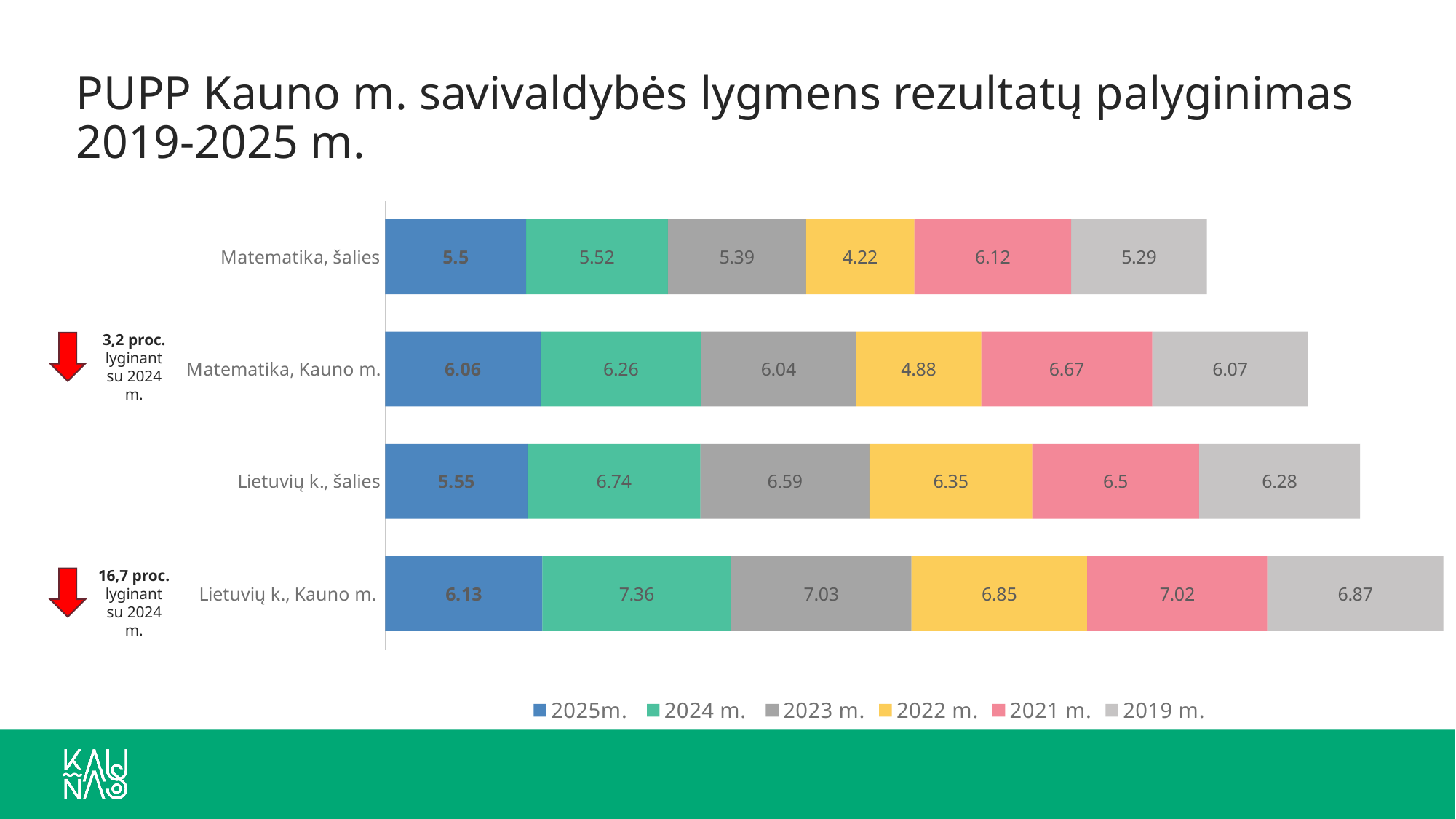
For Matematika, šalies, which is larger: the 2024 m. value or the 2023 m. value? 2024 m. Which category has the highest value in the 2024 m. series? Lietuvių k., Kauno m. What is the value for Lietuvių k., šalies in the 2024 m. series? 6.74 How many series does the legend list? 6 How many categories are shown on the chart? 4 What is the value for Matematika, šalies in the 2022 m. series? 4.22 What is the value for Matematika, Kauno m. in the 2025m. series? 6.06 What kind of chart is shown on the slide? Stacked bar chart What is the total of the stacked bar for Matematika, šalies? 32.04 What is the value for Lietuvių k., Kauno m. in the 2019 m. series? 6.87 Which category has the lowest value in the 2022 m. series? Matematika, šalies What is the difference between the 2024 m. and 2025m. values for Lietuvių k., Kauno m.? 1.23